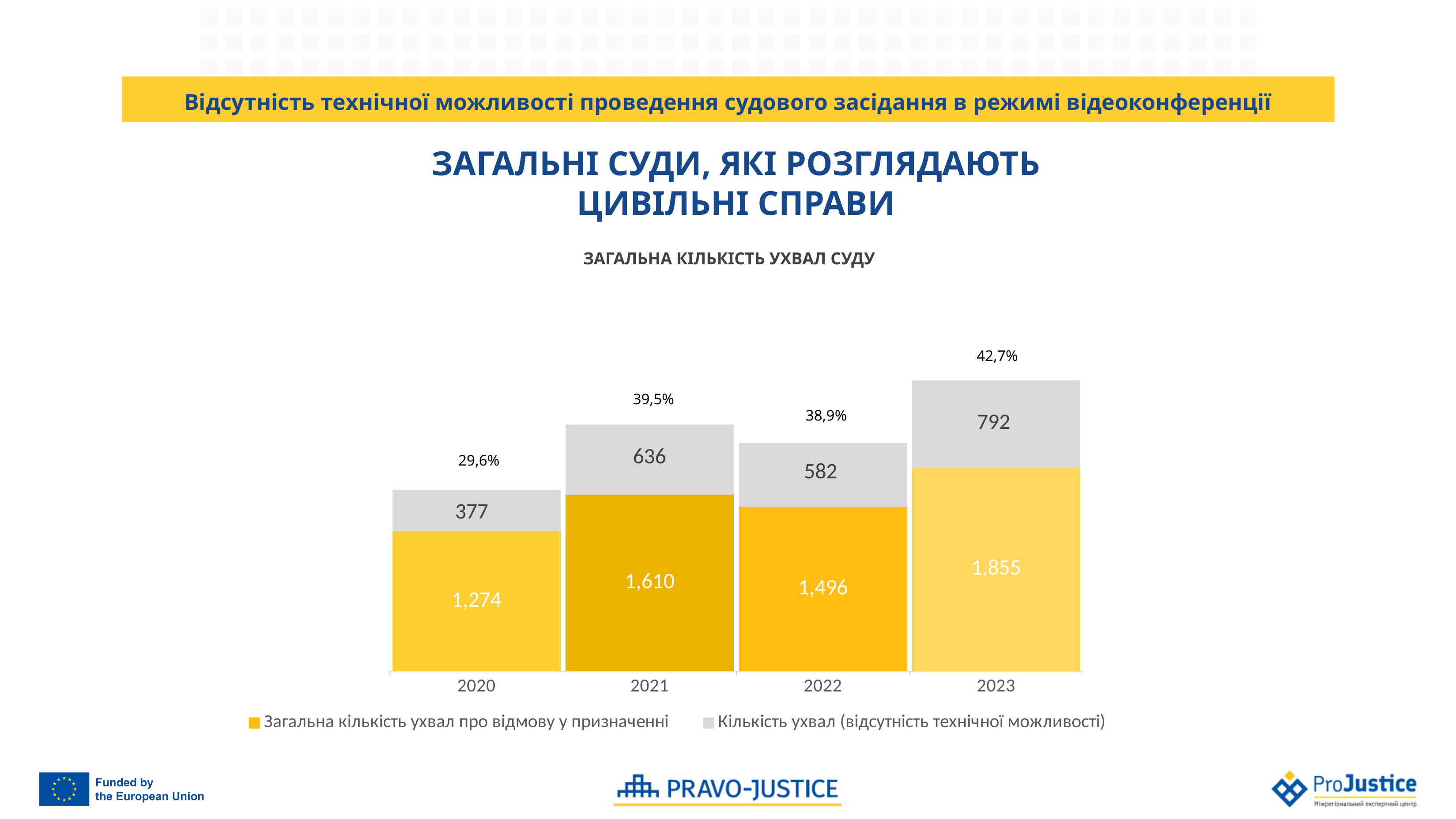
What is the value of "Кількість ухвал (відсутність технічної можливості)" for 2021? 636 What is the value of "Загальна кількість ухвал про відмову у призначенні" for 2022? 1,496 Which year has the highest value for "Кількість ухвал (відсутність технічної можливості)"? 2023 What is the title of the chart? ЗАГАЛЬНА КІЛЬКІСТЬ УХВАЛ СУДУ How many years are shown on the x axis? 4 Which year has the lowest value for "Загальна кількість ухвал про відмову у призначенні"? 2020 What type of chart is shown on the slide? Stacked bar chart What percentage is shown above the bar for 2023? 42,7% What is the total of the stacked bar for 2020? 1,651 Which is larger: the "Загальна кількість ухвал про відмову у призначенні" value for 2021 or for 2022? 2021 How many series does the legend list? 2 What is the difference between the "Кількість ухвал (відсутність технічної можливості)" values for 2023 and 2020? 415